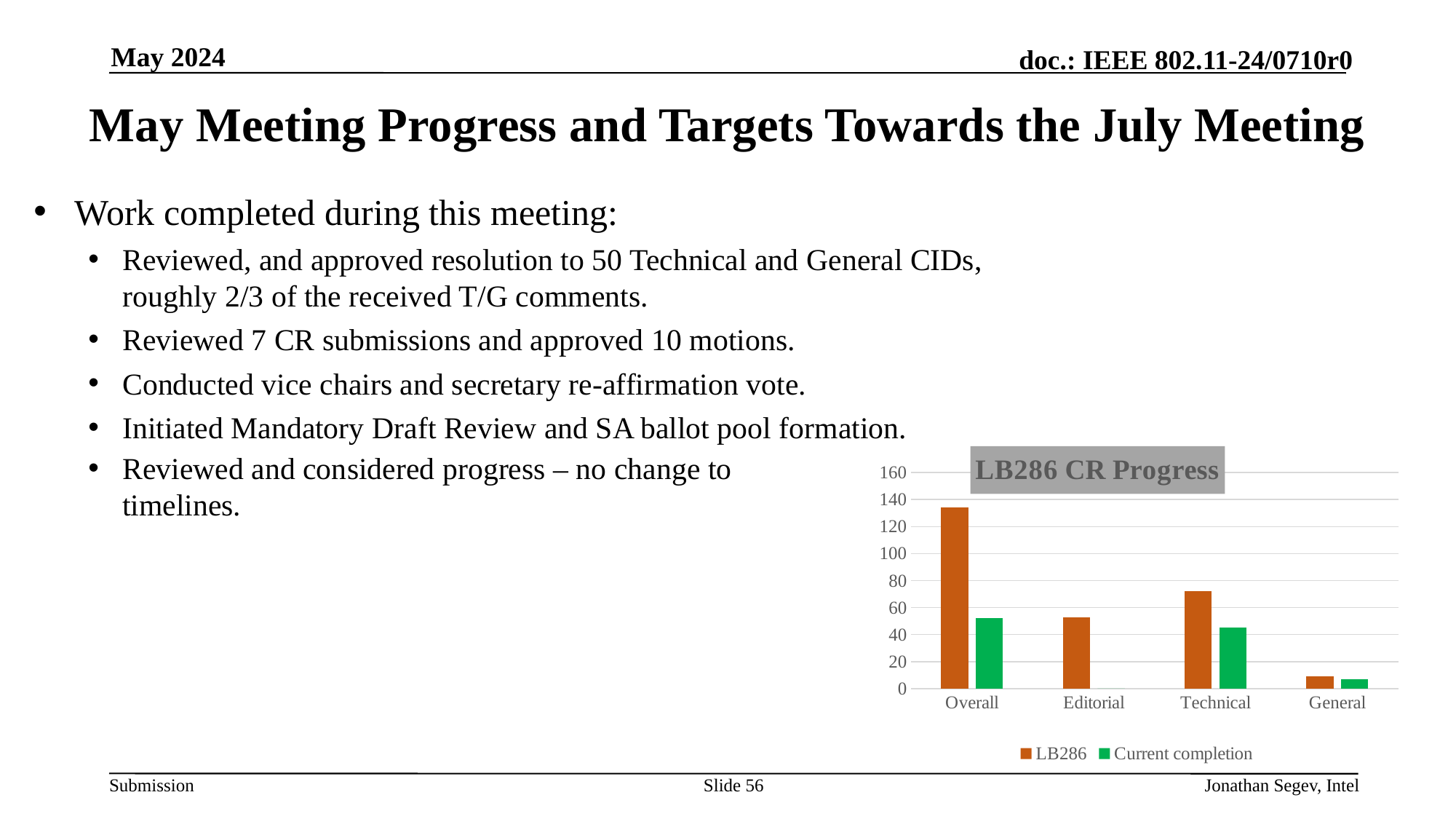
Which series is shown in green in the chart? Current completion Which category has the lowest LB286 value? General What kind of chart is shown on the slide? bar chart How many categories are shown on the x axis of the chart? 4 Is the LB286 value for Technical greater or less than 60? greater What is the title of the chart? LB286 CR Progress Which is larger, the LB286 value for Technical or the LB286 value for Editorial? Technical Which category has the highest LB286 value? Overall Is the LB286 value for Editorial greater or less than 60? less Is the LB286 value for Overall greater or less than 120? greater How many series does the chart legend list? 2